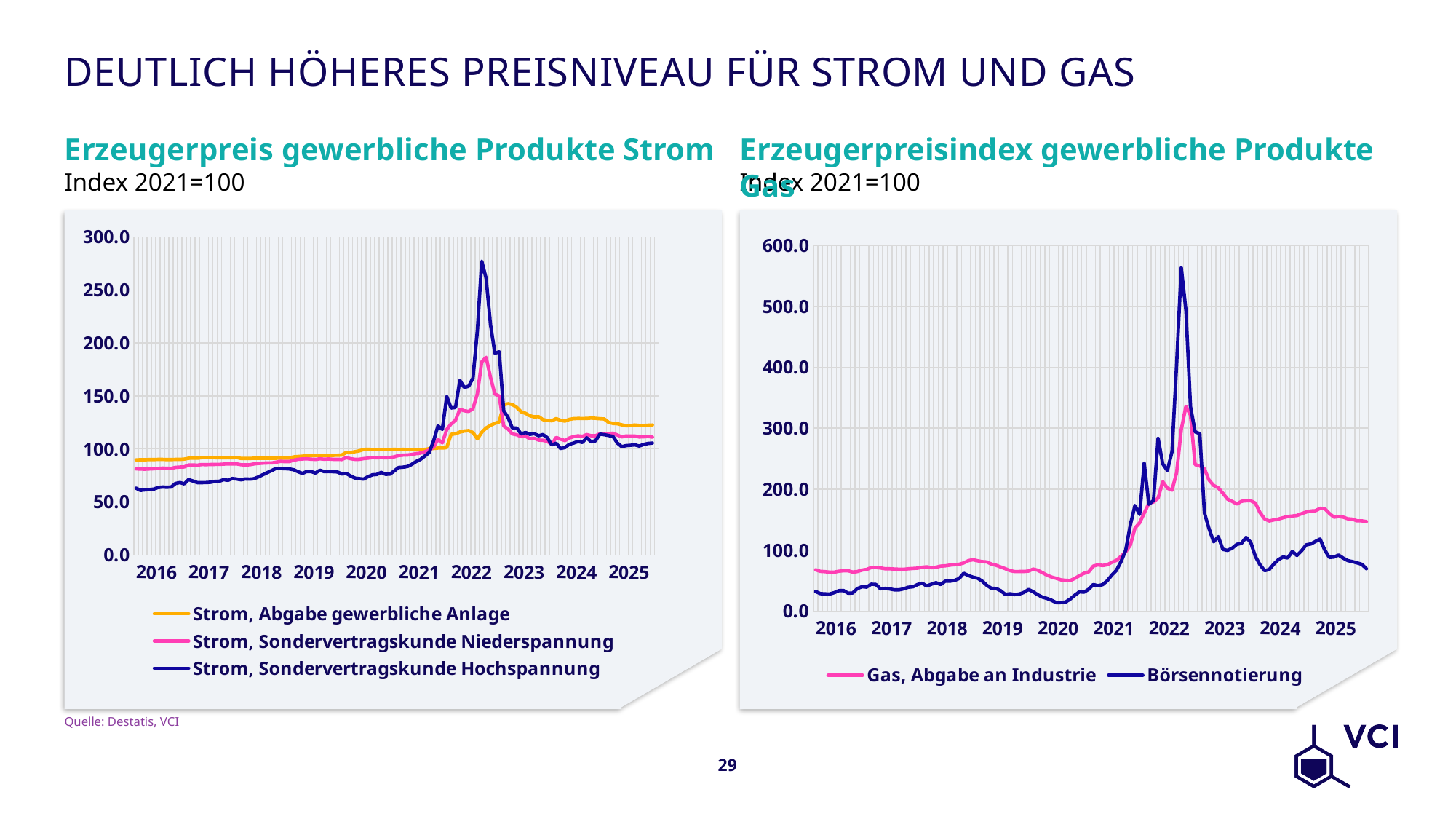
How many series does the legend of the right chart, 'Erzeugerpreisindex gewerbliche Produkte Gas', list? 2 In the left chart, 'Erzeugerpreis gewerbliche Produkte Strom', is the 2022 peak value of 'Strom, Sondervertragskunde Hochspannung' greater or less than 250.0? greater In the right chart, 'Erzeugerpreisindex gewerbliche Produkte Gas', does the 'Börsennotierung' series rise or fall from its 2022 peak to 2025? fall In the left chart, 'Erzeugerpreis gewerbliche Produkte Strom', which series reaches the highest peak in 2022? Strom, Sondervertragskunde Hochspannung In the right chart, 'Erzeugerpreisindex gewerbliche Produkte Gas', is the 2022 peak value of 'Börsennotierung' greater or less than 500.0? greater How many series does the legend of the left chart, 'Erzeugerpreis gewerbliche Produkte Strom', list? 3 In the right chart, 'Erzeugerpreisindex gewerbliche Produkte Gas', which series reaches the highest peak in 2022? Börsennotierung In the right chart, 'Erzeugerpreisindex gewerbliche Produkte Gas', is the 2022 peak value of 'Gas, Abgabe an Industrie' greater or less than 300.0? greater What kind of chart is the left chart, 'Erzeugerpreis gewerbliche Produkte Strom'? line chart In the right chart, 'Erzeugerpreisindex gewerbliche Produkte Gas', which series is higher at the end of 2025: 'Gas, Abgabe an Industrie' or 'Börsennotierung'? Gas, Abgabe an Industrie What is the base year of the index shown in the left chart, 'Erzeugerpreis gewerbliche Produkte Strom'? 2021=100